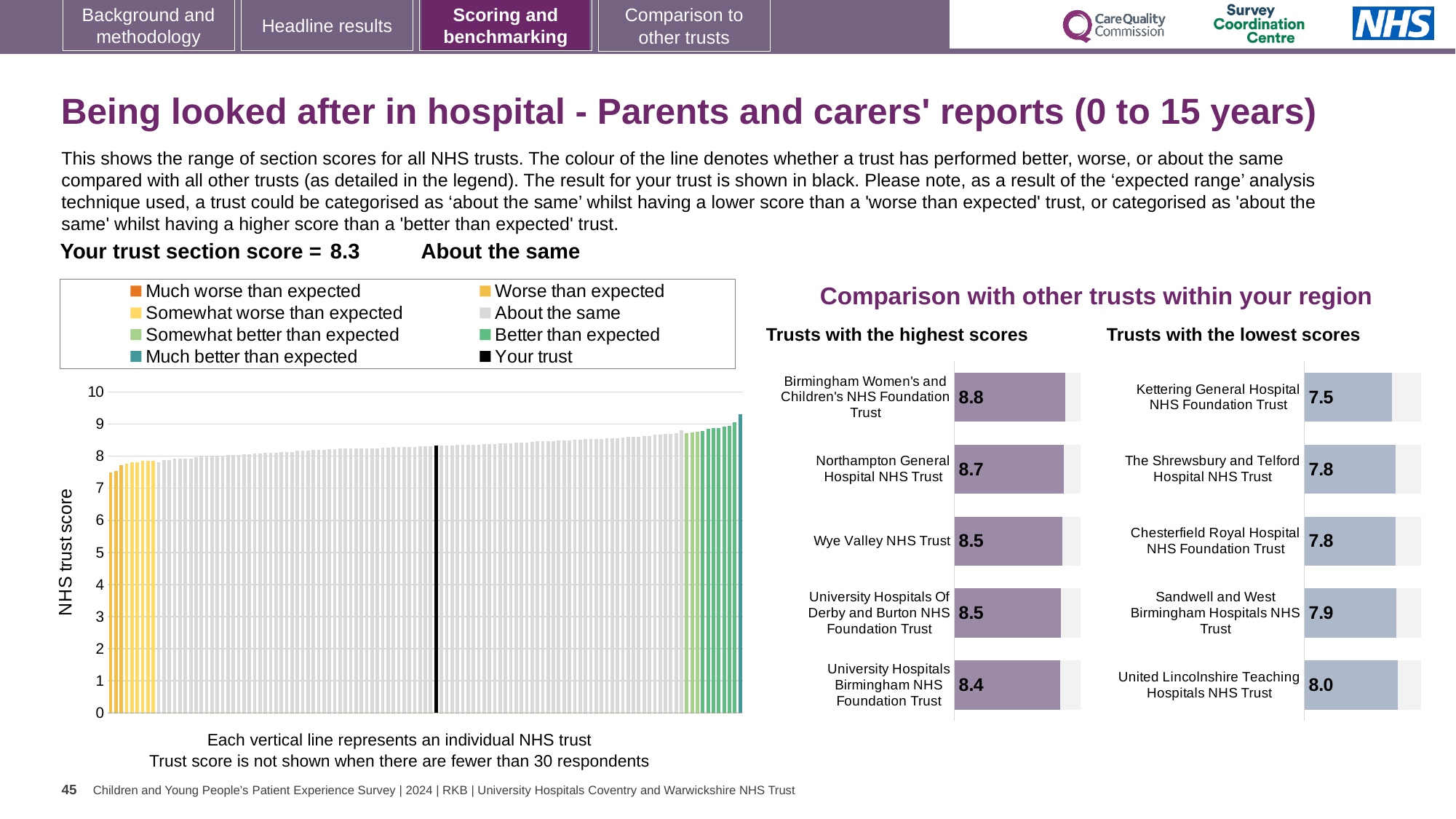
How many entries does the legend of the NHS trust score chart list? 8 In the 'Trusts with the lowest scores' chart, which trust has the lowest score? Kettering General Hospital NHS Foundation Trust In the 'Trusts with the highest scores' chart, which trust has the highest score? Birmingham Women's and Children's NHS Foundation Trust In the 'Trusts with the lowest scores' chart, what is the score for Kettering General Hospital NHS Foundation Trust? 7.5 In the 'Trusts with the lowest scores' chart, which has the larger score: Sandwell and West Birmingham Hospitals NHS Trust or The Shrewsbury and Telford Hospital NHS Trust? Sandwell and West Birmingham Hospitals NHS Trust What is the difference between the score for Birmingham Women's and Children's NHS Foundation Trust in the highest scores chart and the score for Kettering General Hospital NHS Foundation Trust in the lowest scores chart? 1.3 What kind of chart is the 'NHS trust score' chart on the left of the slide? Bar chart In the 'NHS trust score' chart, do the values rise or fall from left to right along the x axis? Rise How many trusts are shown in the 'Trusts with the highest scores' chart? 5 In the 'Trusts with the highest scores' chart, what is the score for Wye Valley NHS Trust? 8.5 In the 'Trusts with the lowest scores' chart, what is the score for United Lincolnshire Teaching Hospitals NHS Trust? 8.0 In the 'Trusts with the highest scores' chart, what is the score for Birmingham Women's and Children's NHS Foundation Trust? 8.8